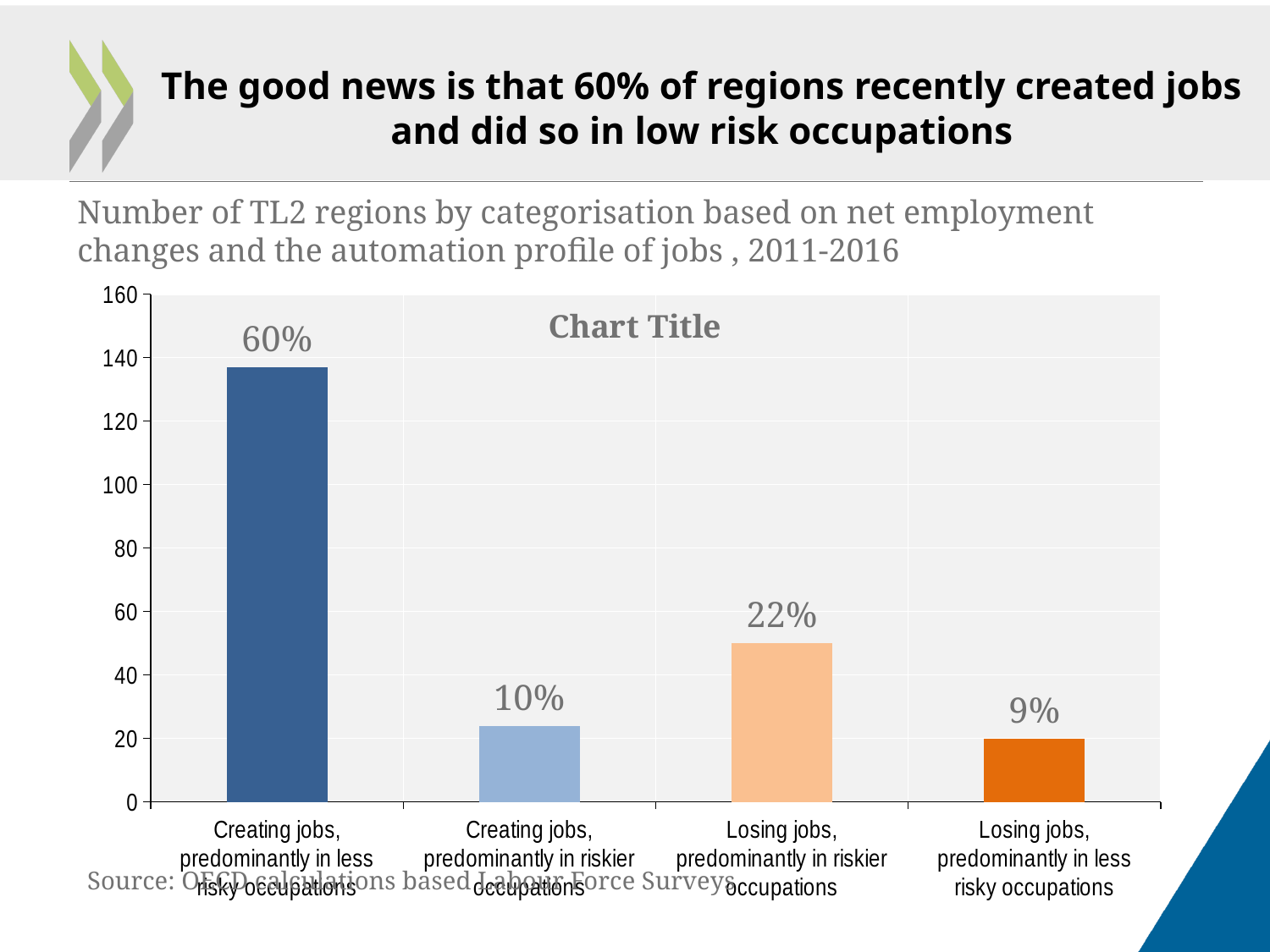
Is the number of regions for 'Creating jobs, predominantly in less risky occupations' greater or less than 120? greater What percentage label is shown above the bar for 'Losing jobs, predominantly in less risky occupations'? 9% What percentage label is shown above the bar for 'Losing jobs, predominantly in riskier occupations'? 22% Is the number of regions for 'Losing jobs, predominantly in riskier occupations' greater or less than 60? less What is the highest value shown on the y axis of the chart? 160 Which category has the lowest bar in the chart? Losing jobs, predominantly in less risky occupations Which bar is taller: 'Losing jobs, predominantly in riskier occupations' or 'Creating jobs, predominantly in riskier occupations'? Losing jobs, predominantly in riskier occupations What percentage label is shown above the bar for 'Creating jobs, predominantly in riskier occupations'? 10% What percentage label is shown above the bar for 'Creating jobs, predominantly in less risky occupations'? 60% How many categories are shown on the x axis of the chart? 4 Which category has the highest bar in the chart? Creating jobs, predominantly in less risky occupations What kind of chart is shown on the slide? bar chart